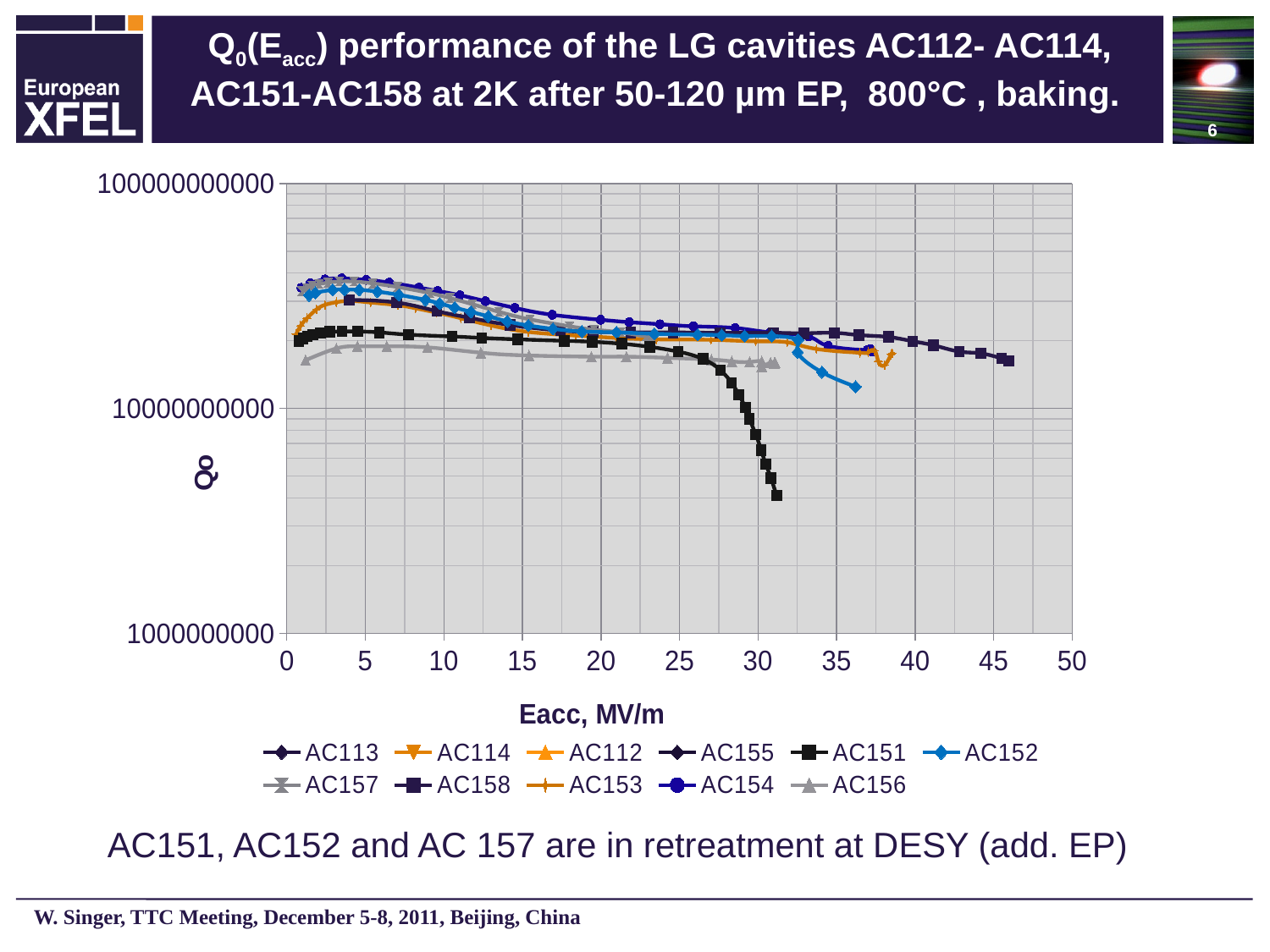
Is the lowest Q0 value reached by AC151 greater or less than 10000000000? less What is the highest value shown on the x axis? 50 Do the Q0 values generally rise or fall as Eacc increases along the x axis? fall Is the Q0 value of AC158 at its highest Eacc point greater or less than 10000000000? greater Which series drops to the lowest Q0 value on the chart? AC151 What is the label of the x axis? Eacc, MV/m Which series reaches a higher Eacc value, AC158 or AC151? AC158 Is the Q0 value of AC152 at its last point (around 36 MV/m) greater or less than 100000000000? less What is the label of the y axis? Q0 Which series extends to the highest Eacc value on the x axis? AC158 How many series does the legend list? 11 What kind of chart is shown on the slide? line chart